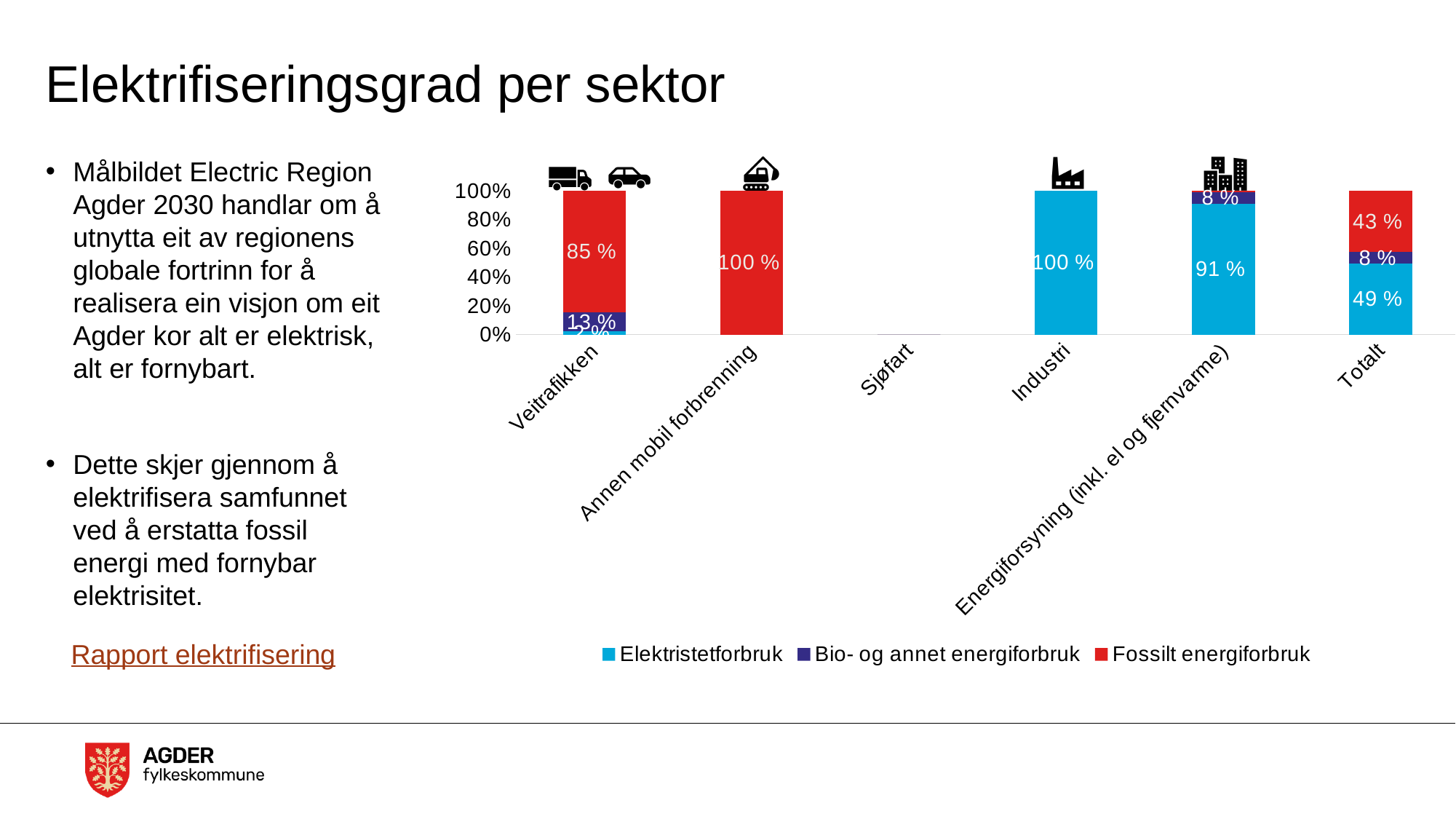
What is the Bio- og annet energiforbruk share for Veitrafikken? 13 % What is the Fossilt energiforbruk share for Veitrafikken? 85 % How many series does the legend list? 3 What kind of chart is shown on the slide? Stacked bar chart What is the Fossilt energiforbruk share for Annen mobil forbrenning? 100 % Which colour represents Fossilt energiforbruk in the chart? Red What is the Fossilt energiforbruk share for Totalt? 43 % What is the difference between the Elektristetforbruk share and the Fossilt energiforbruk share for Totalt? 6 % Which is larger for Totalt: the Elektristetforbruk share or the Fossilt energiforbruk share? Elektristetforbruk How many categories are shown on the x axis? 6 What is the Elektristetforbruk share for Industri? 100 % What is the Elektristetforbruk share for Energiforsyning (inkl. el og fjernvarme)? 91 %